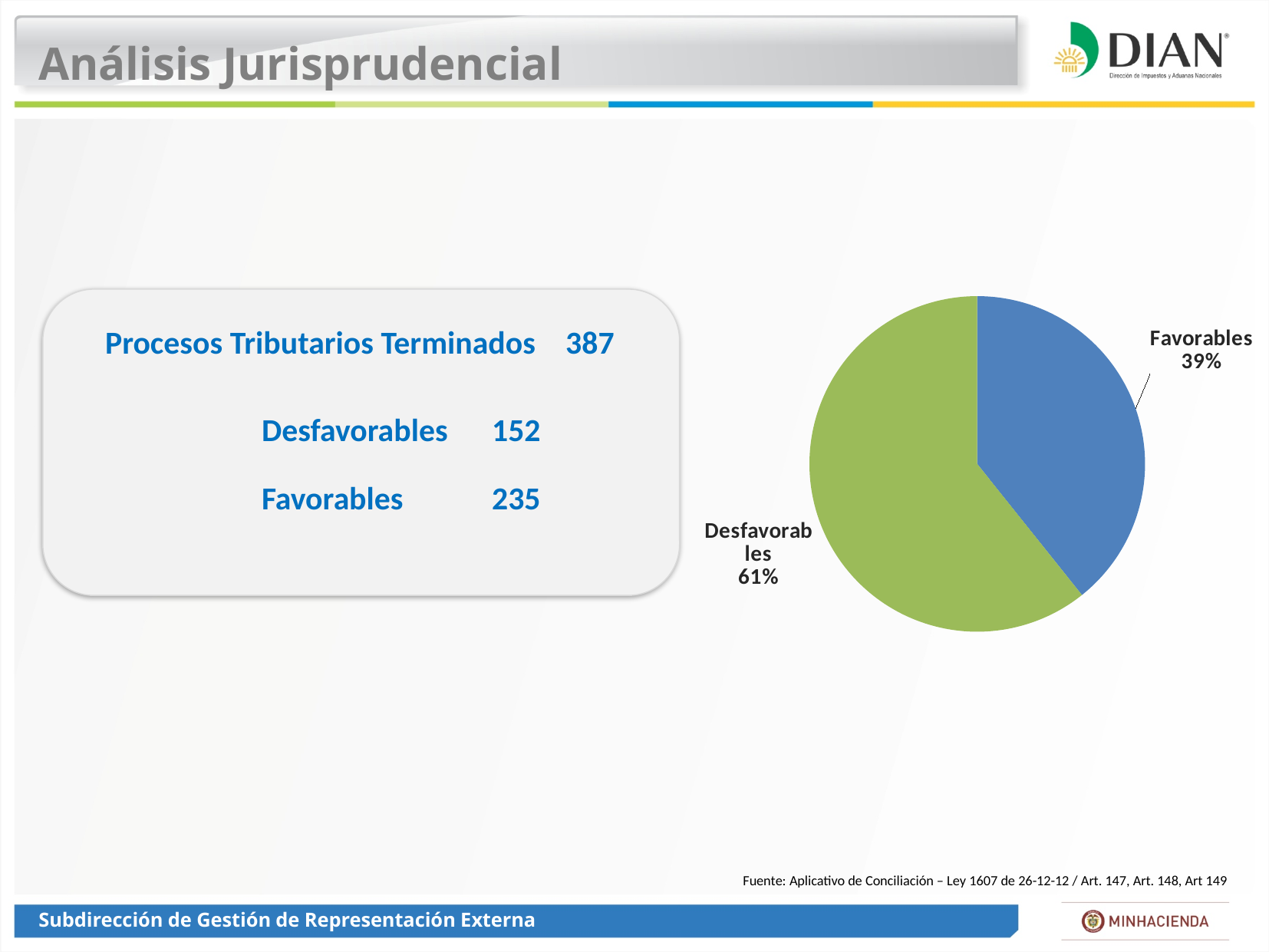
What colour is the Desfavorables slice in the pie chart? Green What share of the pie chart is labelled Favorables? 39% Which slice is larger in the pie chart, Favorables or Desfavorables? Desfavorables Is the Desfavorables share in the pie chart greater or less than 50%? greater By how many percentage points does the Desfavorables slice exceed the Favorables slice in the pie chart? 22 percentage points Which slice of the pie chart is the largest? Desfavorables What colour is the Favorables slice in the pie chart? Blue Which slice of the pie chart is the smallest? Favorables What kind of chart is shown on the slide? Pie chart How many slices does the pie chart have? 2 What share of the pie chart is labelled Desfavorables? 61%